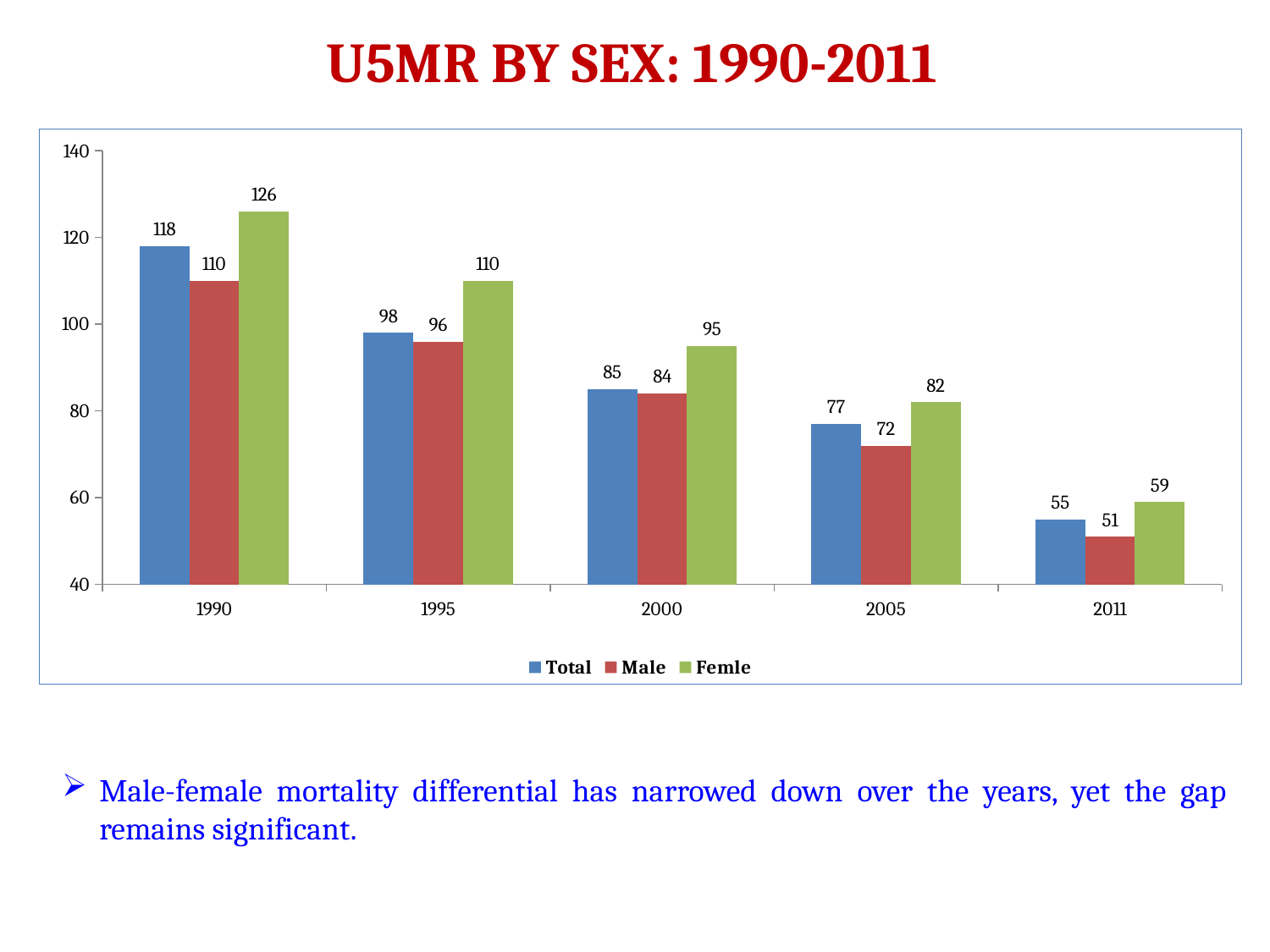
What is the Total U5MR value for 1990? 118 In which year is the Femle U5MR highest? 1990 How many series does the legend list? 3 What is the title of the chart? U5MR BY SEX: 1990-2011 What is the Male U5MR value for 2005? 72 What is the Femle U5MR value for 2011? 59 How many years are shown on the x axis? 5 What kind of chart is shown on the slide? Bar chart What is the difference between the Femle and Male U5MR values in 1990? 16 Do the Total U5MR values rise or fall from 1990 to 2011? Fall In which year is the Male U5MR lowest? 2011 Which is larger in 2000, the Male value or the Femle value? Femle